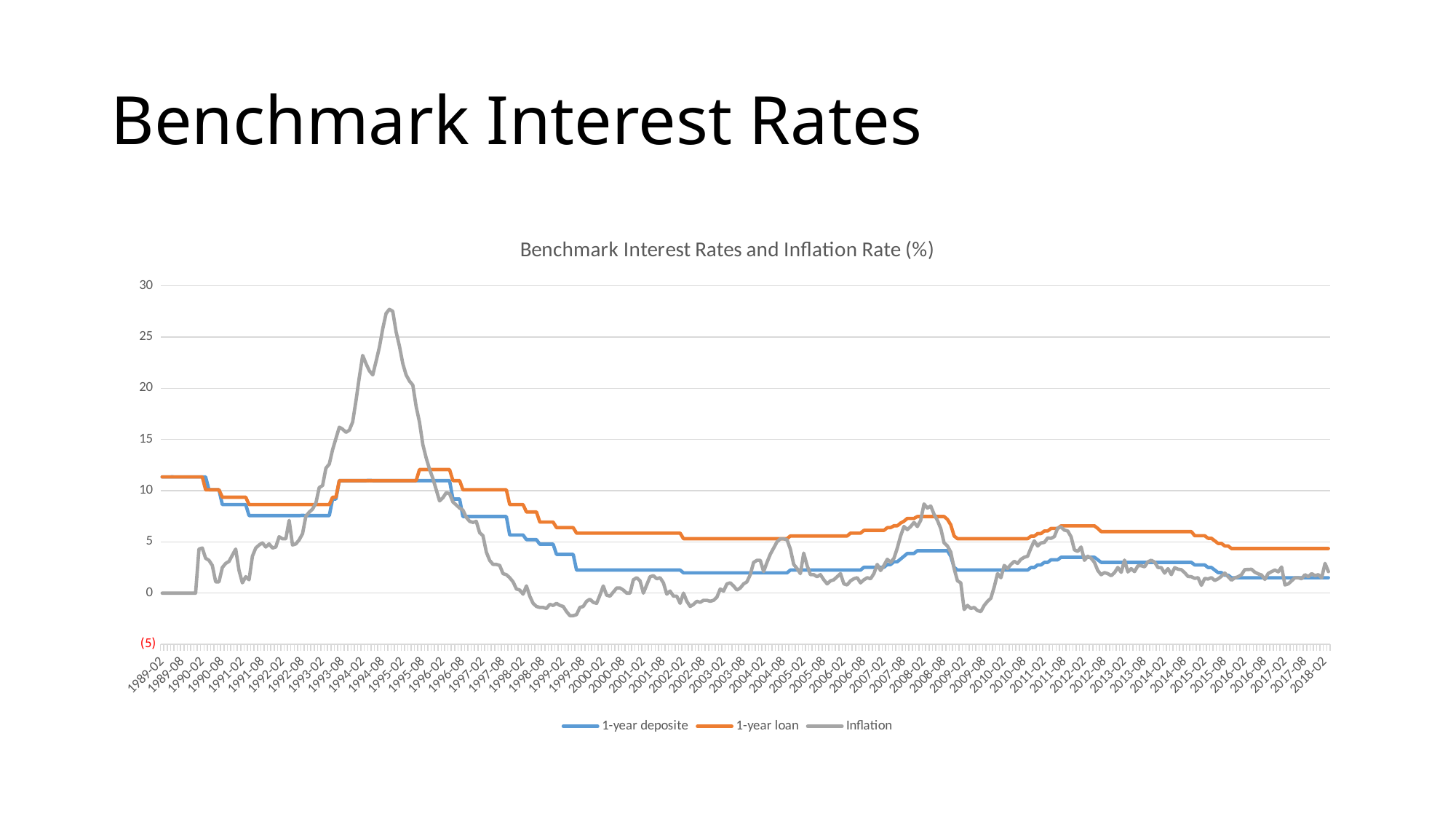
Which series reaches the highest value anywhere on the chart? Inflation Does the 1-year loan series overall rise or fall from 1989-02 to 2018-02? fall How many series does the legend list? 3 What kind of chart is shown on the slide? line chart Is the value of the Inflation series at 1999-02 greater or less than 0? less Is the value of the 1-year loan series at 1989-02 greater or less than 10? greater Is the peak value of the Inflation series around 1994-08 greater or less than 25? greater What is the title of the chart? Benchmark Interest Rates and Inflation Rate (%) Which series has the lowest value at 2018-02? 1-year deposite At 2018-02, which is larger: the 1-year loan or the 1-year deposit? 1-year loan Which series is drawn in grey? Inflation